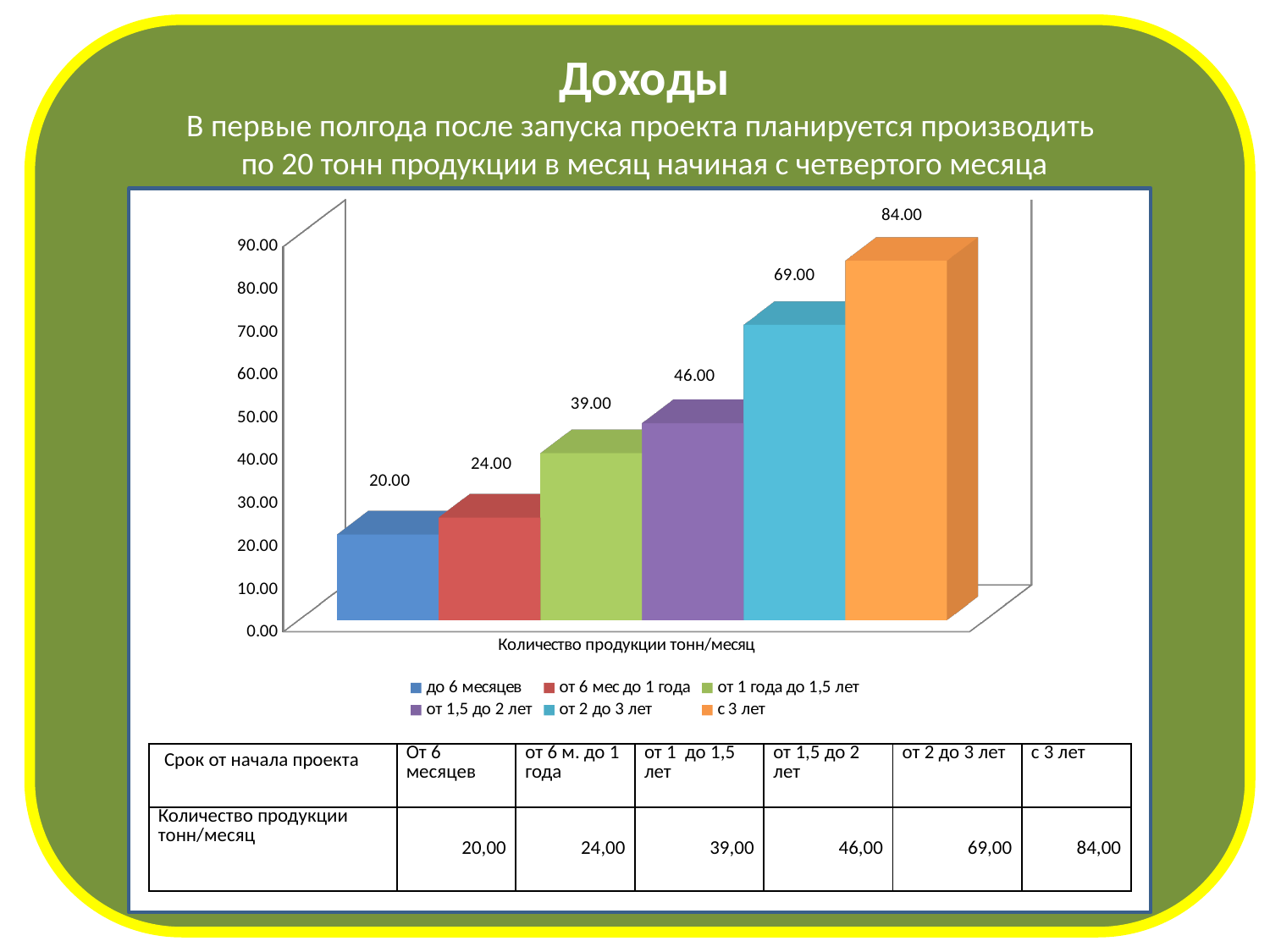
Which is larger, the value for "от 1 года до 1,5 лет" or the value for "от 1,5 до 2 лет"? от 1,5 до 2 лет Which series has the lowest value in the chart? до 6 месяцев What is the value shown for the series "от 1 года до 1,5 лет"? 39.00 What is the value shown for the series "от 2 до 3 лет"? 69.00 Do the values rise or fall from the first series (до 6 месяцев) to the last series (с 3 лет)? rise What is the difference between the values for "с 3 лет" and "от 2 до 3 лет"? 15.00 What is the difference between the values for "от 1,5 до 2 лет" and "от 6 мес до 1 года"? 22.00 How many series does the legend list? 6 What is the category label shown on the x axis of the chart? Количество продукции тонн/месяц What kind of chart is shown on the slide? bar chart Which series has the highest value in the chart? с 3 лет What is the value shown for the series "до 6 месяцев"? 20.00